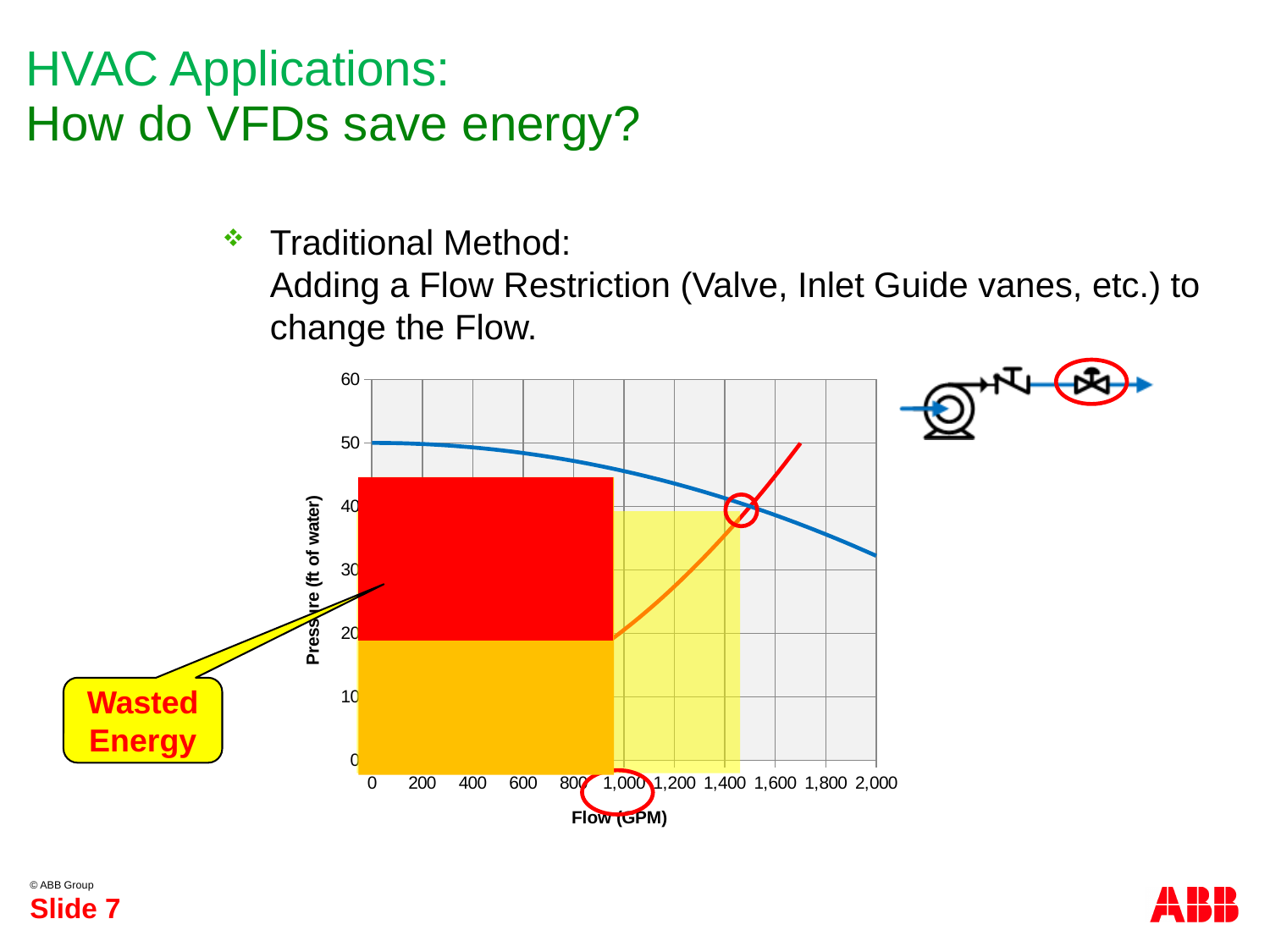
Does the blue pump curve rise or fall as flow increases along the x axis? fall What is the maximum value shown on the y axis of the chart? 60 What kind of chart is shown on the slide? line chart Is the pressure on the blue curve at a flow of 1,000 GPM greater or less than 40? greater What is the title of the y axis of the chart? Pressure (ft of water) What is the title of the x axis of the chart? Flow (GPM) How many tick labels are shown on the x axis of the chart? 11 Is the pressure on the blue curve higher at a flow of 200 GPM or at a flow of 1,800 GPM? 200 GPM Is the pressure on the blue curve at a flow of 2,000 GPM greater or less than 30? greater What is the maximum value shown on the x axis of the chart? 2,000 Is the pressure on the blue curve at a flow of 400 GPM greater or less than 40? greater